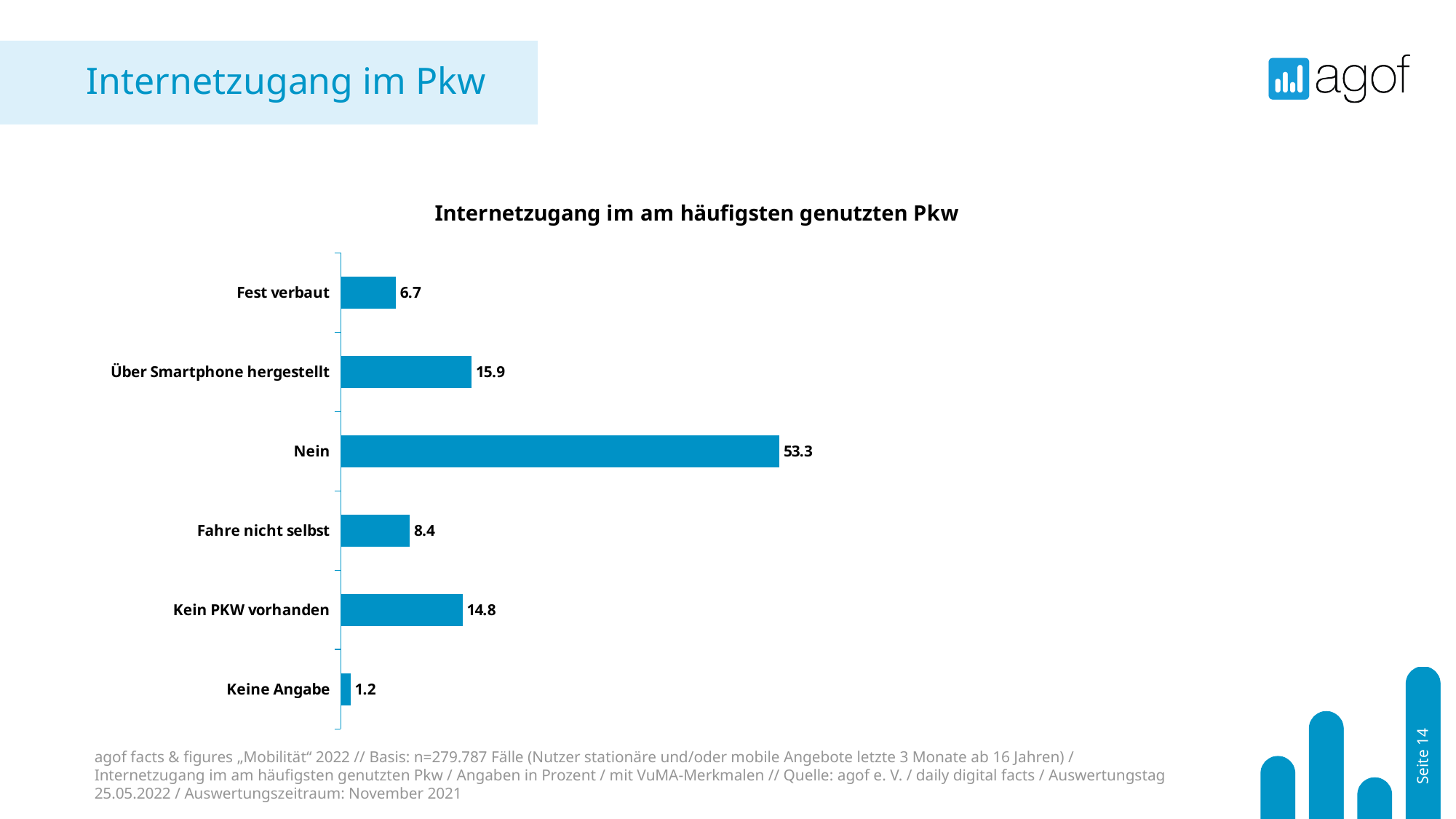
What is the title of the chart? Internetzugang im am häufigsten genutzten Pkw How many categories are shown in the chart? 6 What kind of chart is shown on the slide? Bar chart What is the value for "Kein PKW vorhanden"? 14.8 Which category has the highest value? Nein What is the difference between the values for "Nein" and "Über Smartphone hergestellt"? 37.4 Which category has the lowest value? Keine Angabe Which is larger, the value for "Über Smartphone hergestellt" or the value for "Kein PKW vorhanden"? Über Smartphone hergestellt What is the value for "Fest verbaut"? 6.7 What is the value for "Über Smartphone hergestellt"? 15.9 What is the difference between the values for "Fahre nicht selbst" and "Fest verbaut"? 1.7 What is the value for "Nein"? 53.3